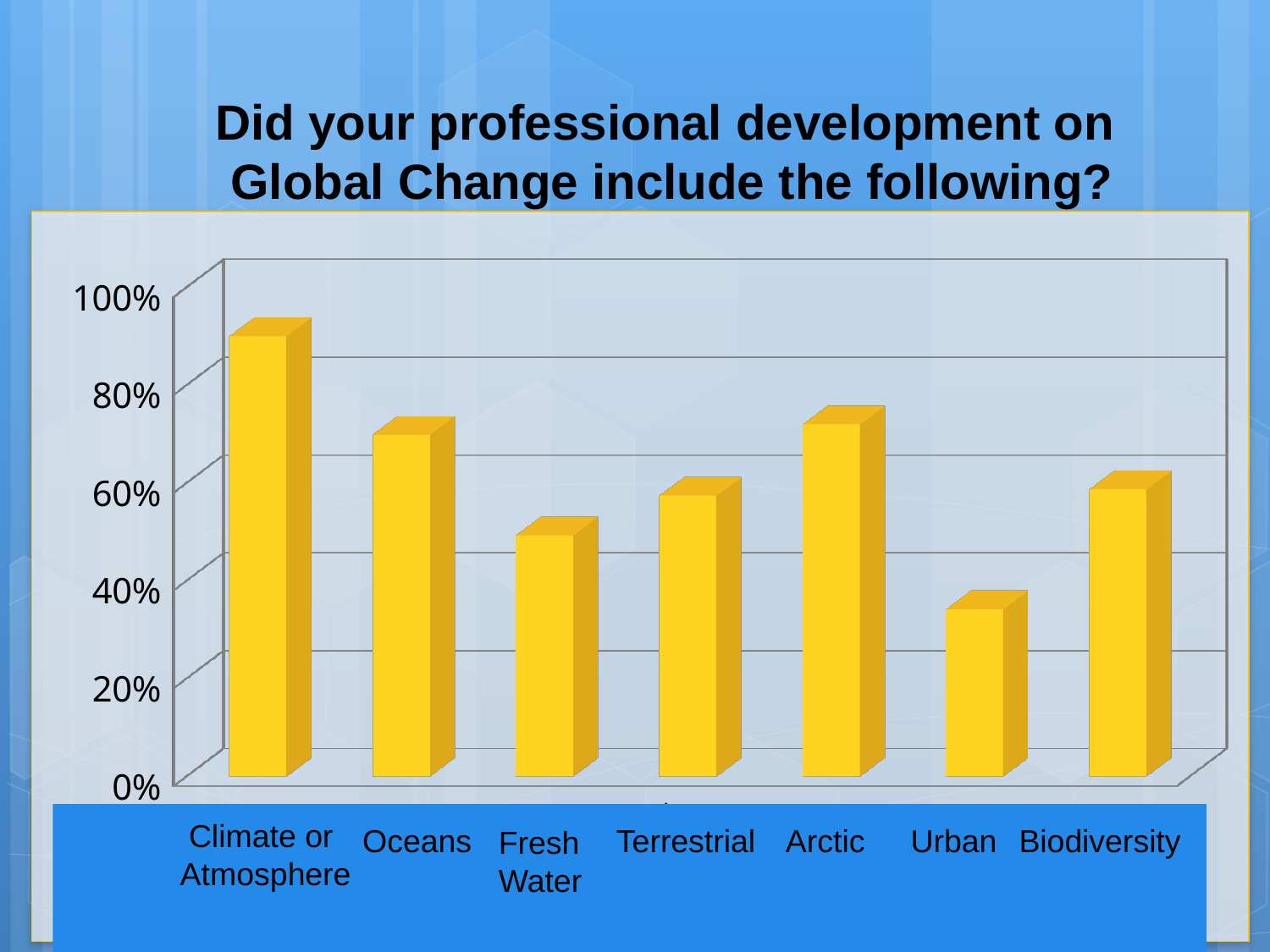
How many categories are shown on the x axis of the chart? 7 Is the value for Fresh Water greater or less than 60%? less Which category has the lowest value? Urban Which is larger, the value for Climate or Atmosphere or the value for Oceans? Climate or Atmosphere What kind of chart is shown on the slide? bar chart What is the title of the chart? Did your professional development on Global Change include the following? Is the value for Arctic greater or less than 60%? greater Is the value for Urban greater or less than 40%? less Which category has the highest value? Climate or Atmosphere Which is larger, the value for Arctic or the value for Urban? Arctic